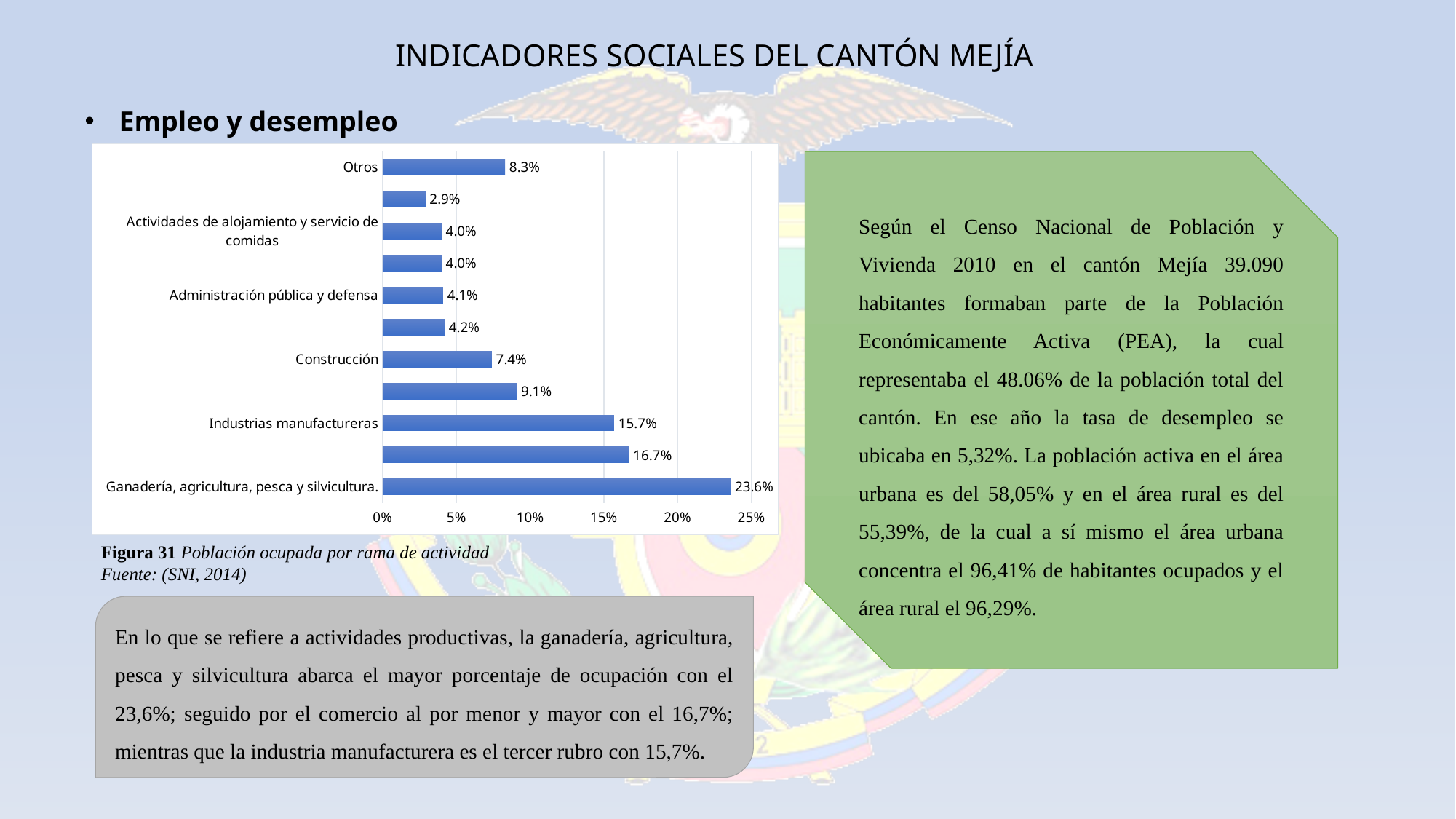
What is the value for Actividades de alojamiento y servicio de comidas? 4.0% What is the value for Industrias manufactureras? 15.7% Which is larger, the value for Otros or the value for Construcción? Otros What is the value for Otros? 8.3% How many bars are plotted in the chart? 11 What kind of chart is shown on the slide? Bar chart What is the value for Administración pública y defensa? 4.1% What is the difference between the values for Ganadería, agricultura, pesca y silvicultura and Industrias manufactureras? 7.9% What is the value for Construcción? 7.4% Which category has the highest value? Ganadería, agricultura, pesca y silvicultura. What is the value for Ganadería, agricultura, pesca y silvicultura? 23.6% What is the smallest value shown on any bar in the chart? 2.9%